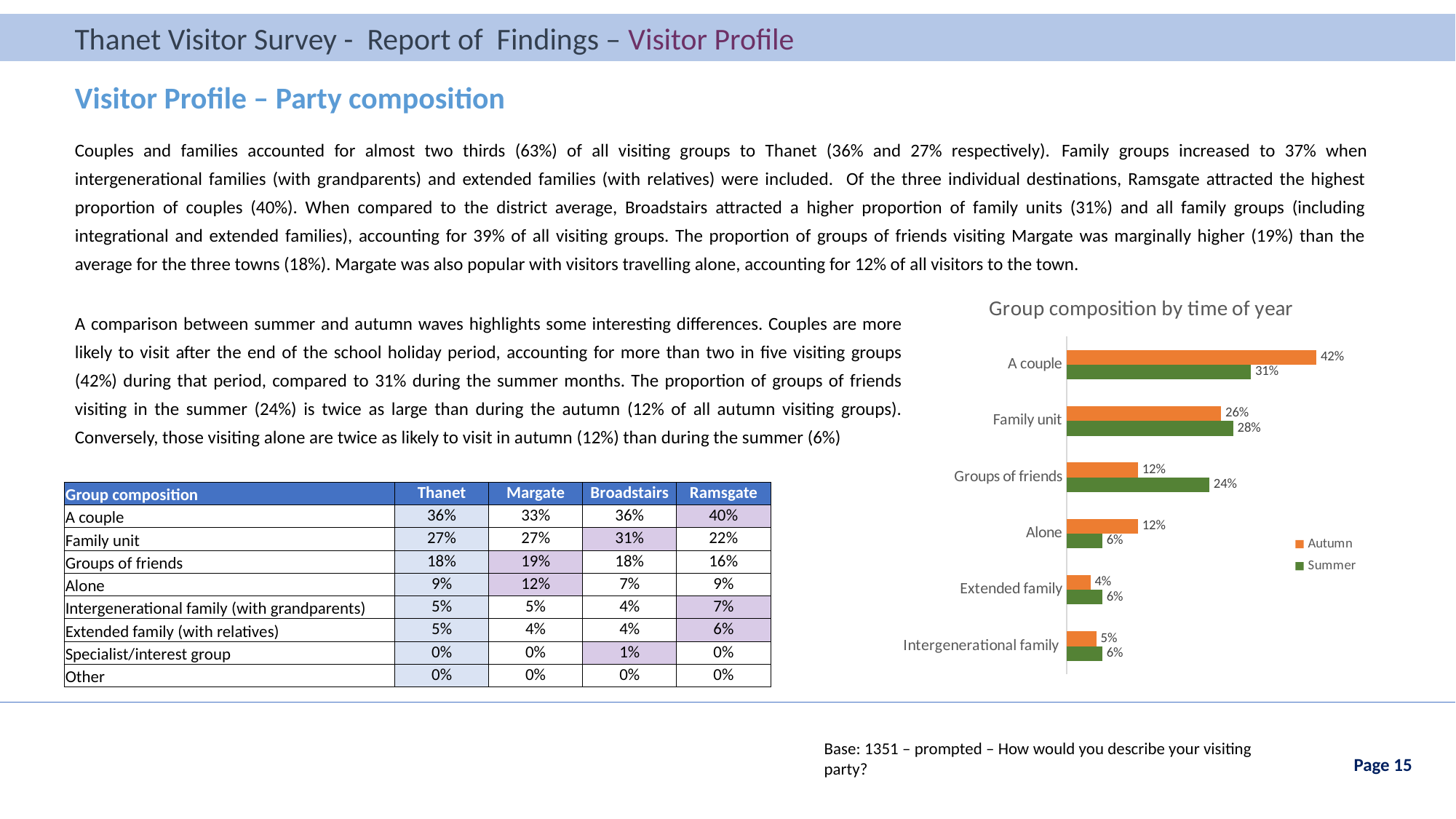
What is the difference between the Summer and Autumn values for Groups of friends in the Group composition by time of year chart? 12% What is the Summer value for Family unit in the Group composition by time of year chart? 28% In the Group composition by time of year chart, is the Autumn or Summer value larger for Alone? Autumn Which category has the highest Autumn value in the Group composition by time of year chart? A couple What is the Autumn value for A couple in the Group composition by time of year chart? 42% How many series does the legend of the Group composition by time of year chart list? 2 What is the difference between the Autumn and Summer values for A couple in the Group composition by time of year chart? 11% Which category has the lowest Autumn value in the Group composition by time of year chart? Extended family What is the Autumn value for Extended family in the Group composition by time of year chart? 4% What is the Summer value for Groups of friends in the Group composition by time of year chart? 24% How many categories are shown in the Group composition by time of year chart? 6 What type of chart is the Group composition by time of year chart? Bar chart